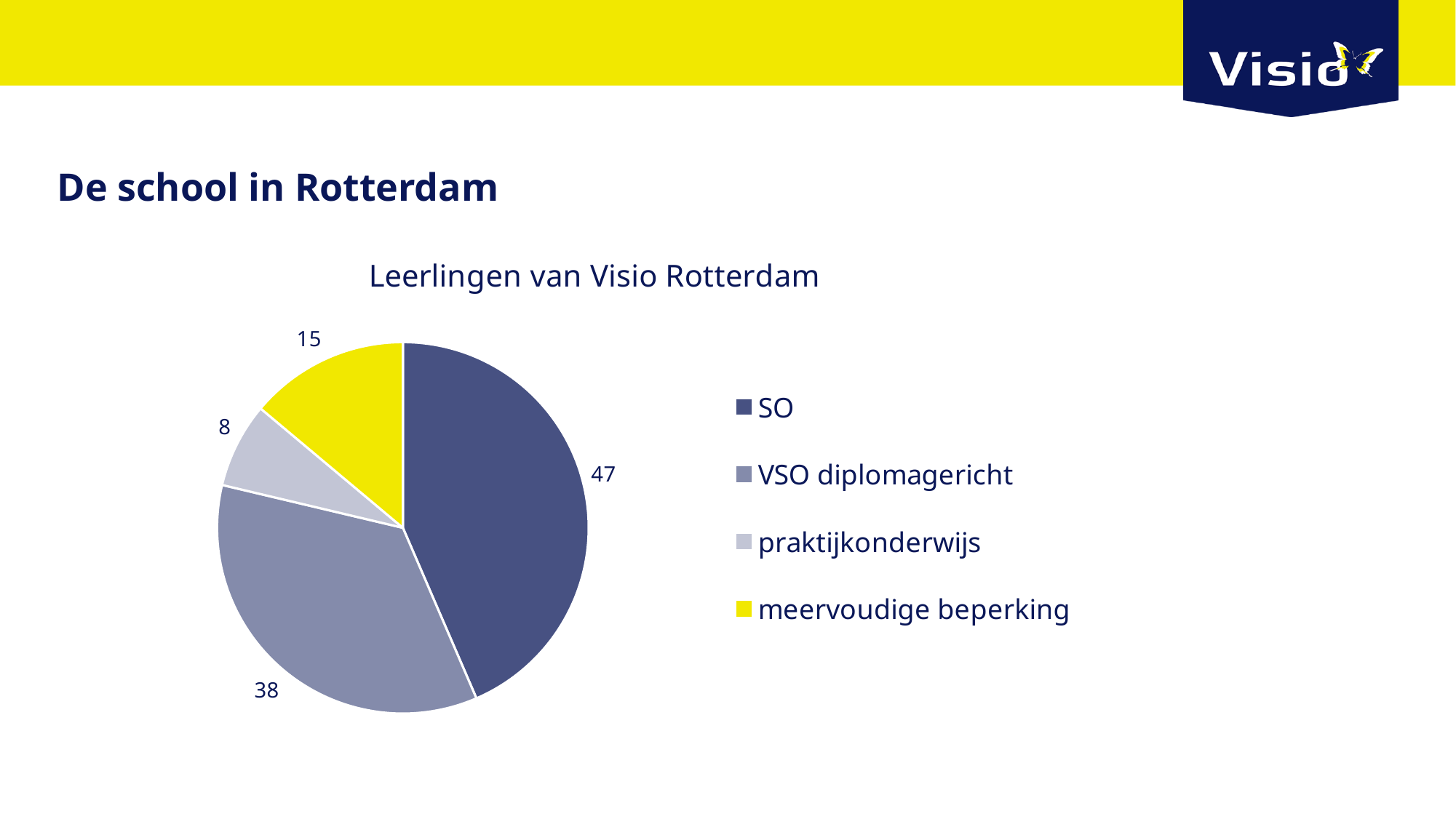
What is the value for VSO diplomagericht? 38 Which is larger, meervoudige beperking or praktijkonderwijs? meervoudige beperking Which category has the smallest slice? praktijkonderwijs What is the title of the chart? Leerlingen van Visio Rotterdam Which category has the largest slice? SO What is the value for meervoudige beperking? 15 What is the value for SO? 47 What type of chart is shown on the slide? pie chart What is the difference between the values for SO and VSO diplomagericht? 9 What is the total of all slices in the pie chart? 108 How many categories does the pie chart show? 4 What is the value for praktijkonderwijs? 8